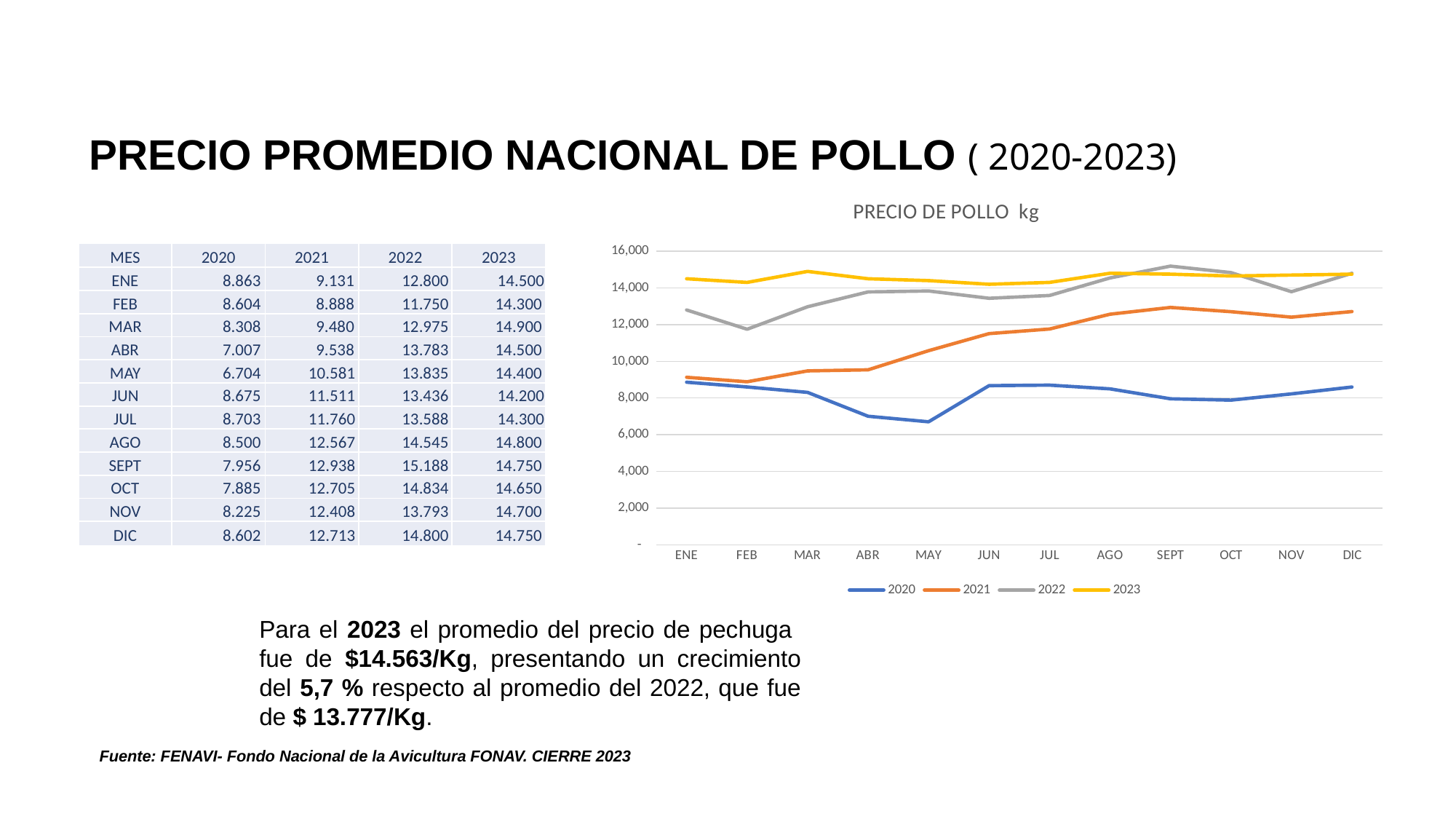
What is the difference between the 2023 and 2020 values in DIC? 6.148 How many months are plotted along the x axis of the chart? 12 What is the value for 2022 in SEPT? 15.188 In which month does the 2020 series reach its lowest value? MAY Is the value for 2020 in MAY greater or less than 8,000? less Does the 2021 series generally rise or fall from ENE to DIC? rise How many series does the legend of the chart list? 4 What is the value for 2023 in MAR? 14.900 In ENE, which series has the larger value, 2021 or 2022? 2022 What kind of chart is shown on the slide? line chart In which month does the 2022 series reach its highest value? SEPT What is the title of the chart? PRECIO DE POLLO kg